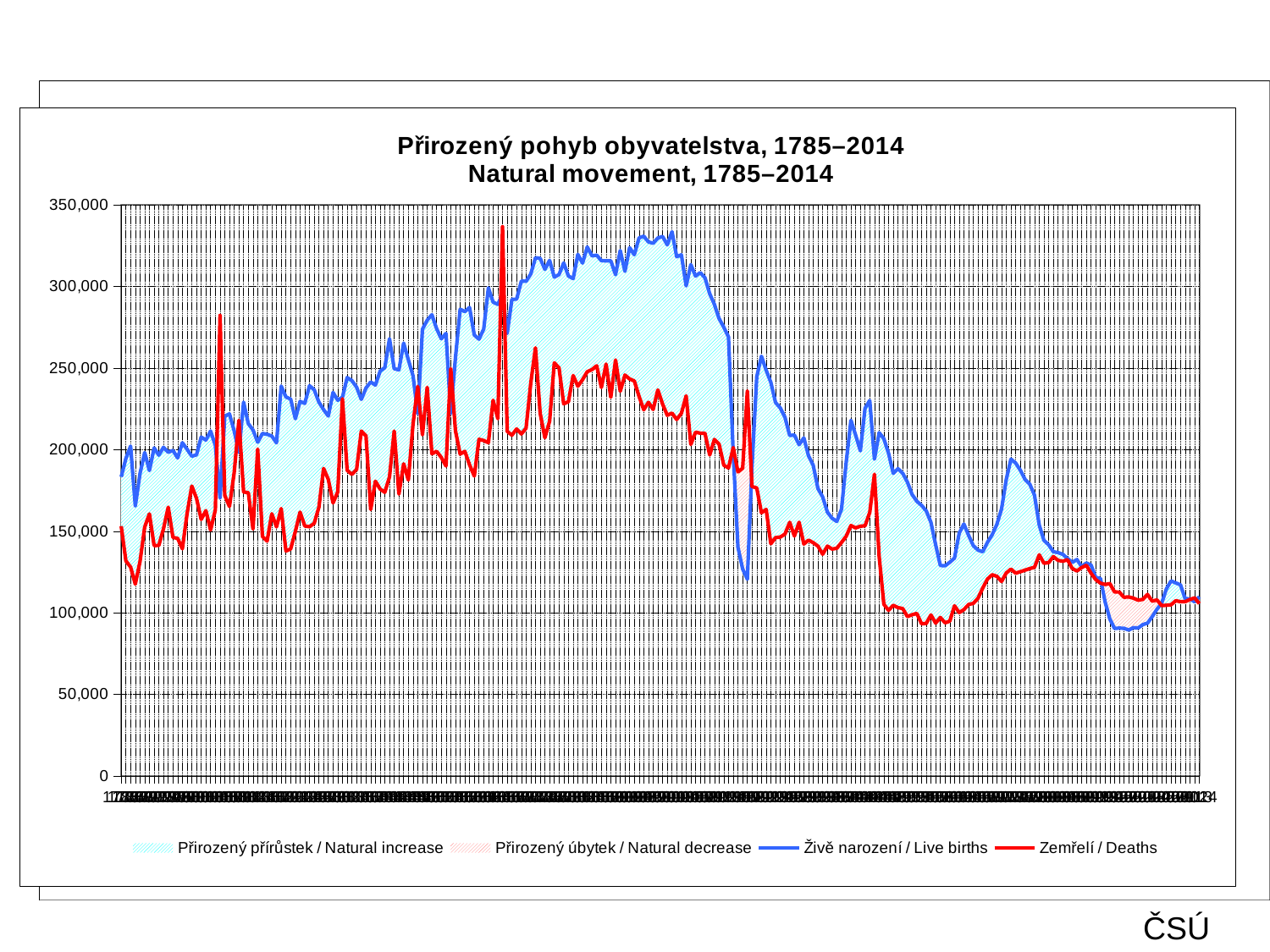
What period does the chart cover according to its title? 1785–2014 Which series is higher for most of the period shown, Živě narození / Live births or Zemřelí / Deaths? Živě narození / Live births Is the lowest value of Živě narození / Live births greater or less than 100,000? less Does the Živě narození / Live births line rise or fall over the last third of the period shown? fall What kind of chart is shown on the slide? line chart How many entries does the legend list? 4 Is the value for Živě narození / Live births at the start of the series (1785) greater or less than 150,000? greater Is the value for Živě narození / Live births at the end of the series (2014) greater or less than 150,000? less What colour is the line for Živě narození / Live births? blue What is the highest value shown on the vertical axis? 350,000